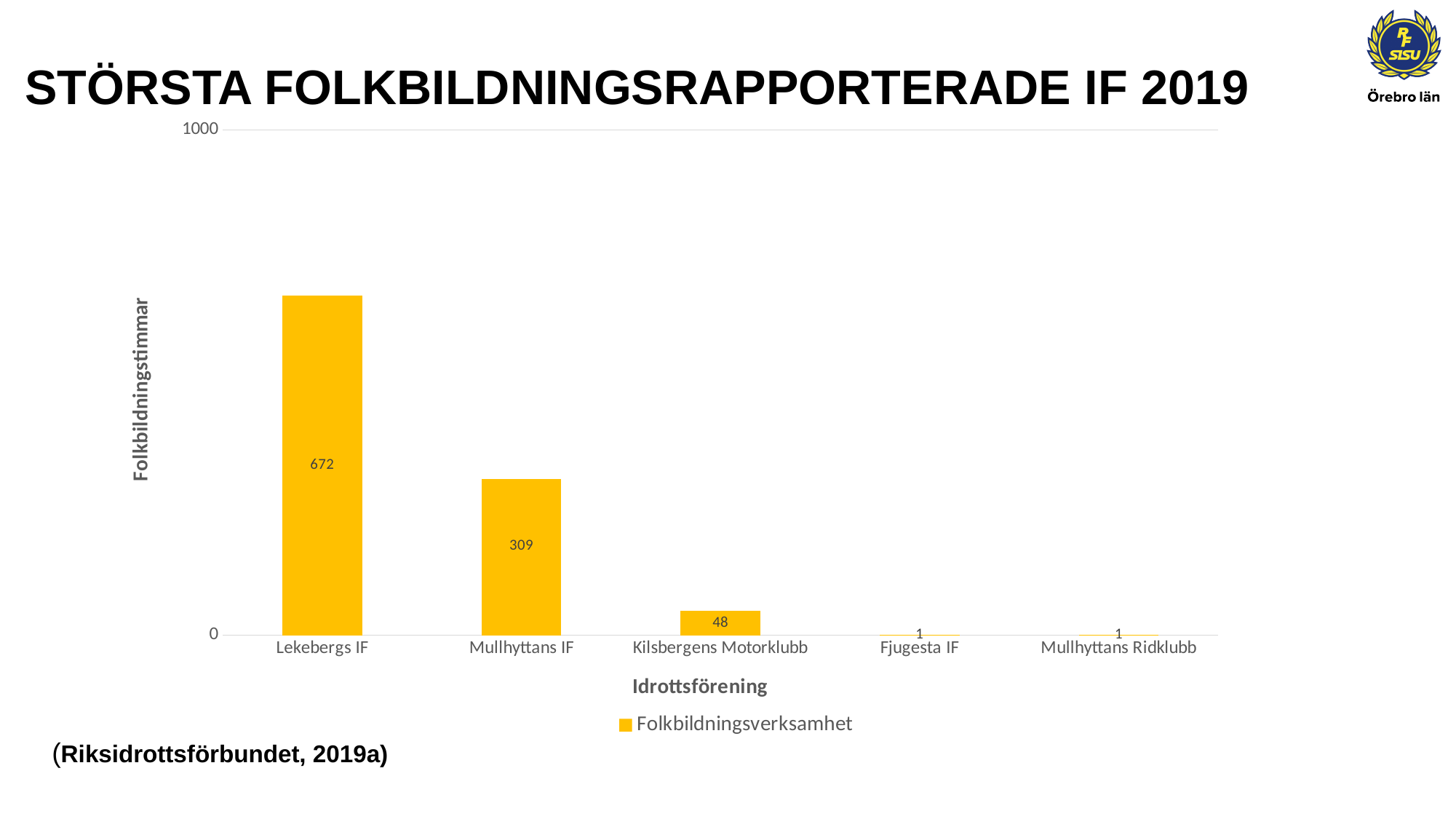
What is the difference between the values for Lekebergs IF and Mullhyttans IF? 363 What is the value for Mullhyttans IF? 309 What is the value for Kilsbergens Motorklubb? 48 Which category has the highest value? Lekebergs IF What is the value for Fjugesta IF? 1 What is the difference between the values for Mullhyttans IF and Kilsbergens Motorklubb? 261 How many categories are shown on the x axis? 5 What kind of chart is shown on the slide? bar chart What is the label of the y axis? Folkbildningstimmar Which is larger, the value for Mullhyttans IF or the value for Kilsbergens Motorklubb? Mullhyttans IF How many series does the legend list? 1 What is the value for Lekebergs IF? 672